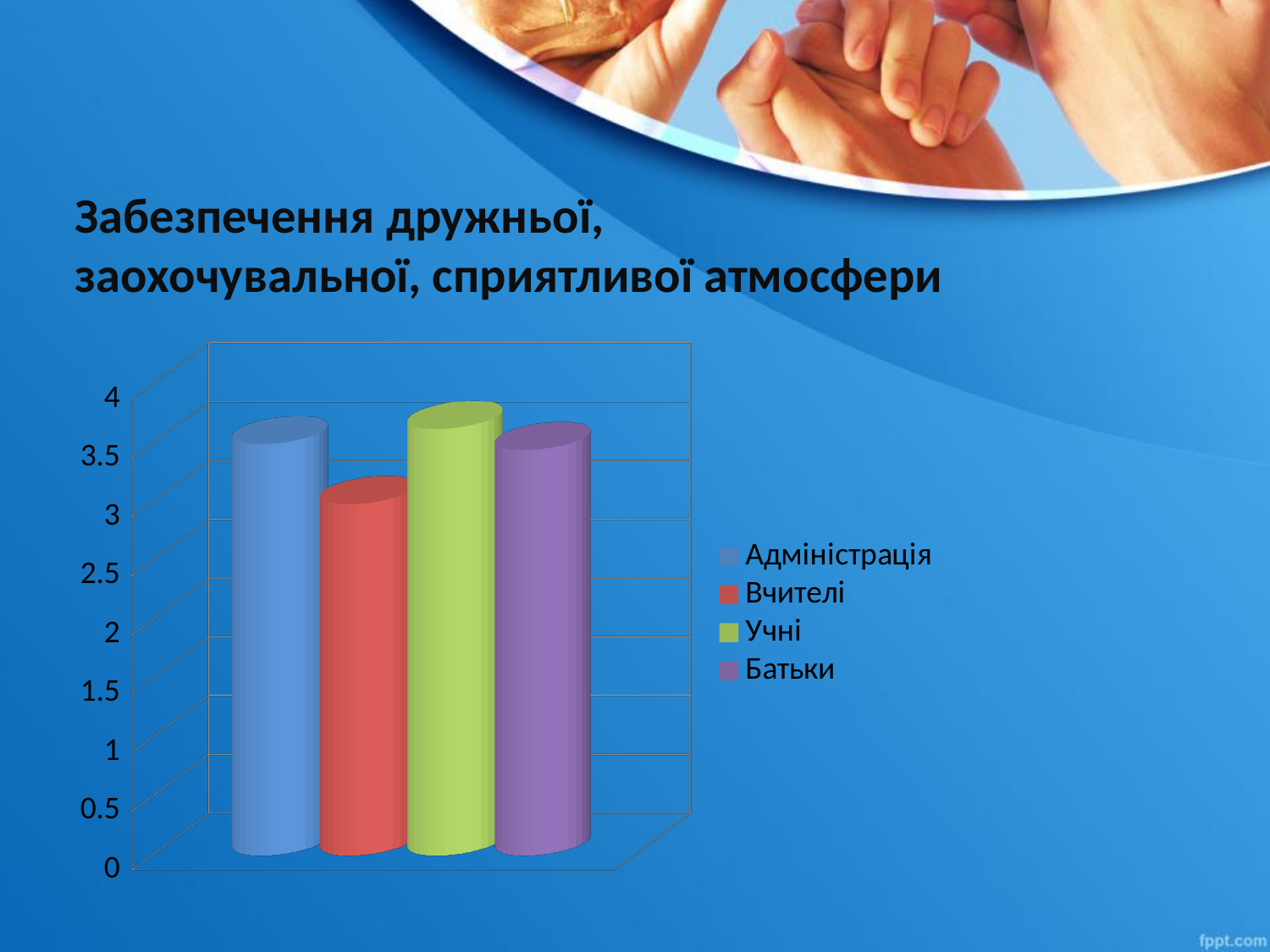
Which series has the lowest value? Вчителі Which series has the highest value? Учні How many series does the legend list? 4 What colour is the bar for Учні? green What is the title of the slide above the chart? Забезпечення дружньої, заохочувальної, сприятливої атмосфери Which is larger, the value for Учні or the value for Вчителі? Учні Is the value for Вчителі greater or less than 3.5? less Which is larger, the value for Вчителі or the value for Батьки? Батьки Is the value for Адміністрація greater or less than 3? greater Is the value for Батьки greater or less than 3? greater What kind of chart is shown on the slide? bar chart